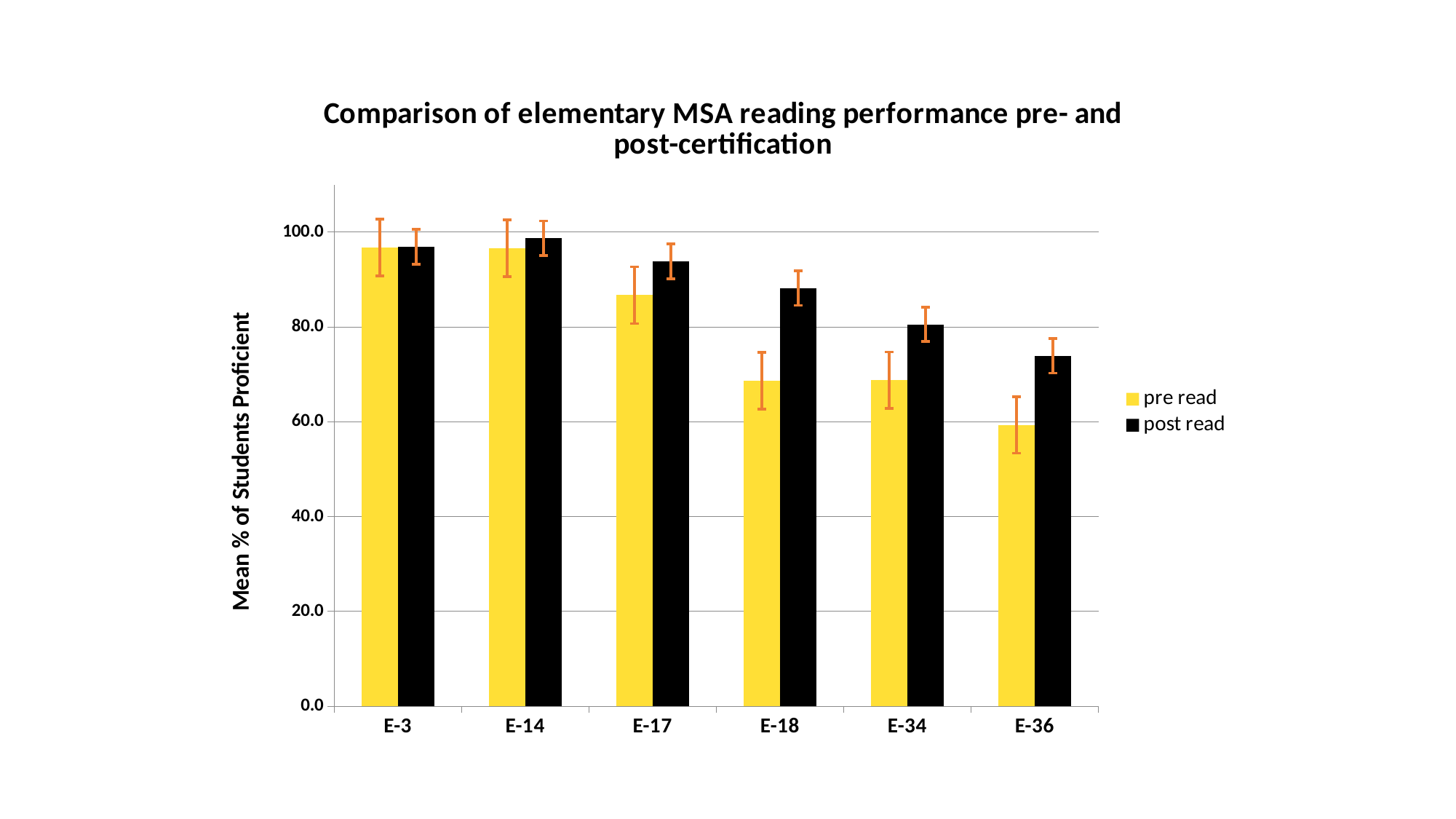
For E-18, which is larger: the pre read value or the post read value? post read Is the post read value for E-36 greater or less than 80.0? less Is the pre read value for E-17 greater or less than 80.0? greater How many series does the legend list? 2 Is the pre read value for E-18 greater or less than 80.0? less How many schools (categories) are shown on the x axis? 6 What is the label of the y axis? Mean % of Students Proficient Which school has the lowest pre read value? E-36 What kind of chart is shown on the slide? bar chart Which school has the lowest post read value? E-36 For E-36, which is larger: the pre read value or the post read value? post read